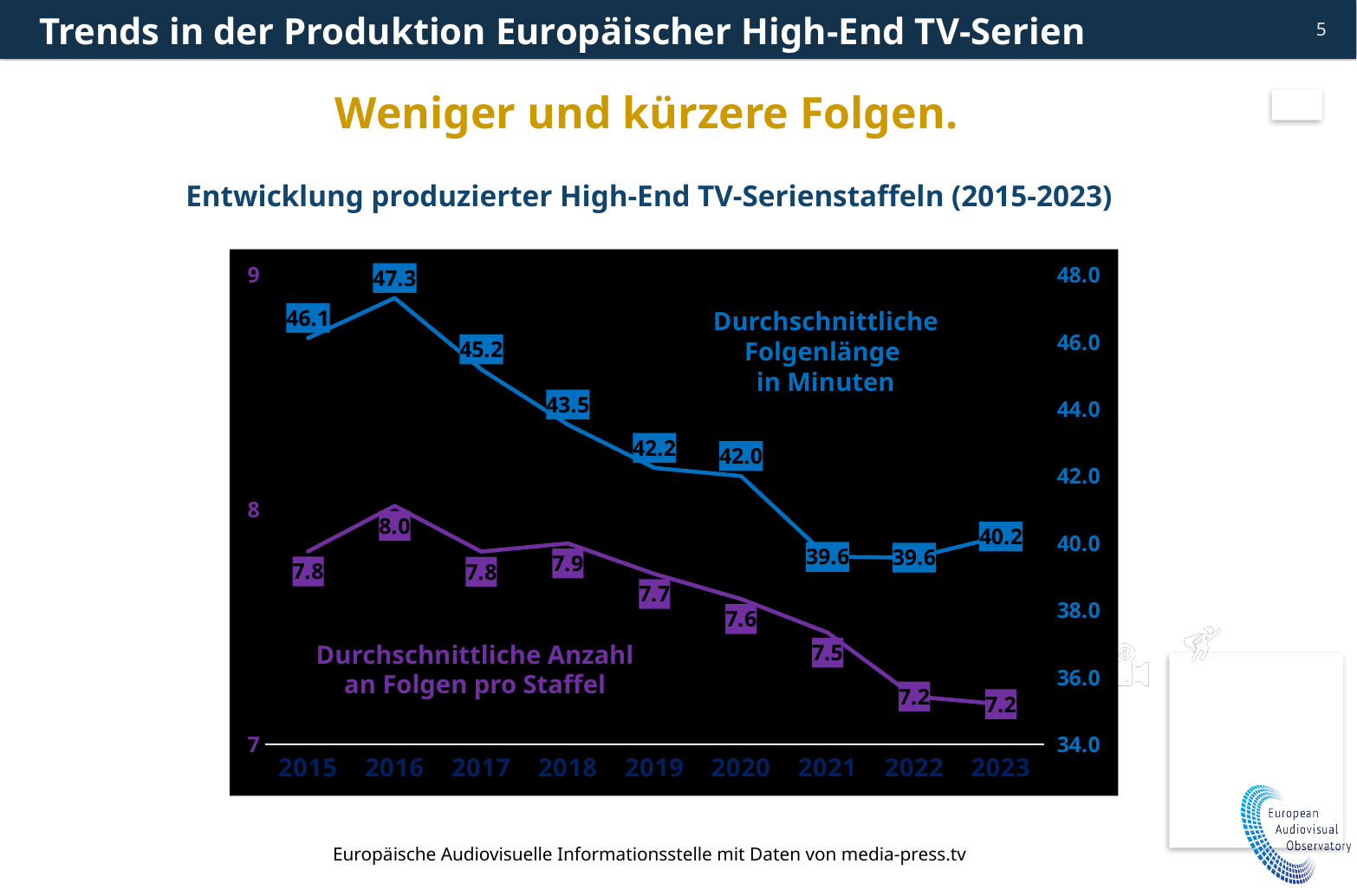
How many years are shown on the x axis of the chart? 9 What kind of chart is shown on the slide? Line chart In which year is the average number of episodes per season highest? 2016 Which year has a longer average episode length, 2019 or 2022? 2019 In which year is the average episode length in minutes highest? 2016 How many data series does the chart show? 2 What is the difference in the average number of episodes per season between 2016 and 2022? 0.8 What is the average episode length in minutes for 2021? 39.6 Does the average episode length in minutes generally rise or fall from 2016 to 2022? Fall What is the difference in average episode length in minutes between 2015 and 2023? 5.9 What is the average number of episodes per season (Durchschnittliche Anzahl an Folgen pro Staffel) for 2023? 7.2 What is the average episode length in minutes (Durchschnittliche Folgenlänge) for 2016? 47.3